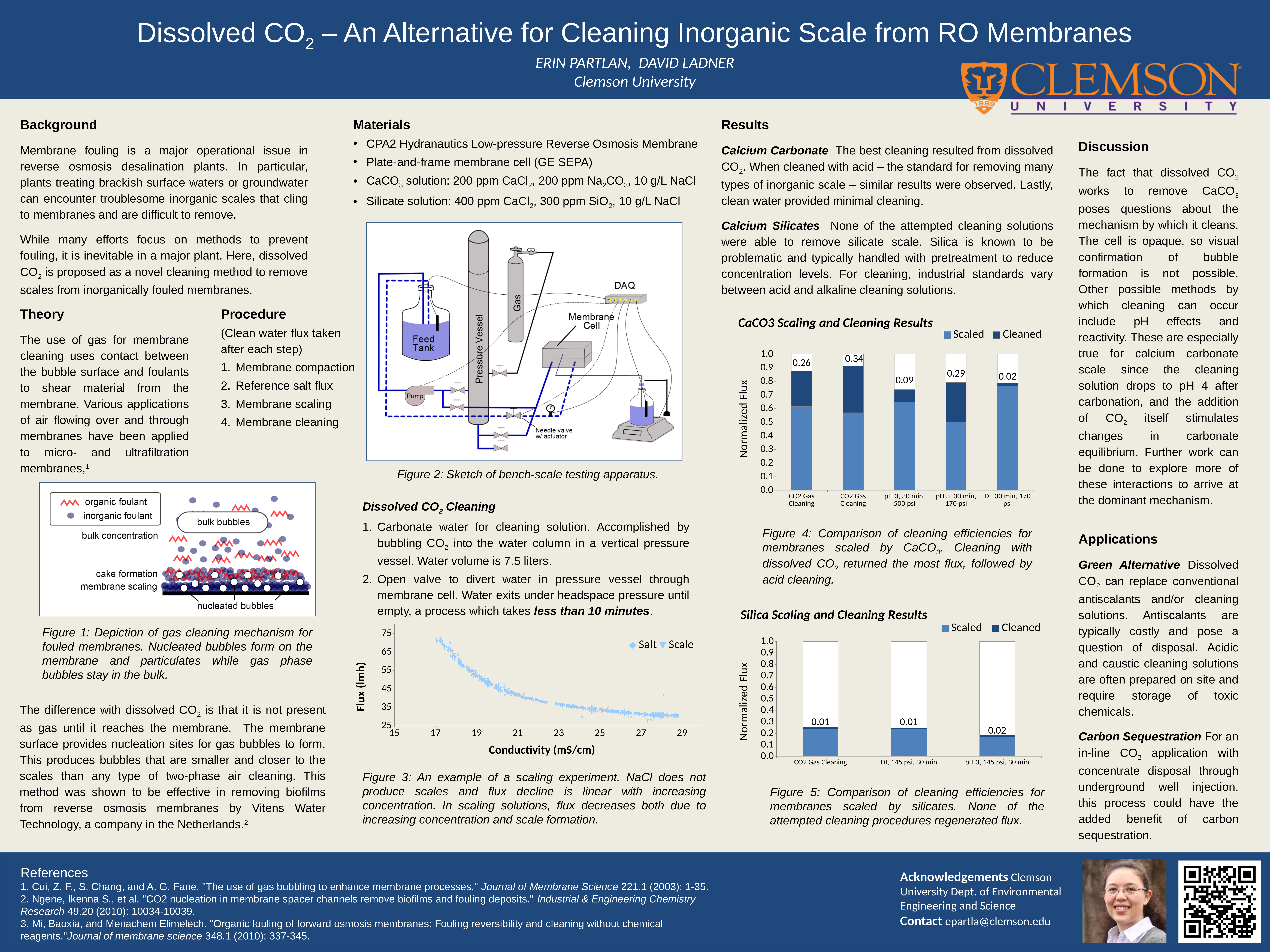
In the 'Silica Scaling and Cleaning Results' chart, how many categories are shown on the x axis? 3 In the 'CaCO3 Scaling and Cleaning Results' chart, what is the difference between the Cleaned values for 'pH 3, 30 min, 170 psi' and 'pH 3, 30 min, 500 psi'? 0.20 In the 'CaCO3 Scaling and Cleaning Results' chart, what kind of chart is shown? bar chart In the 'CaCO3 Scaling and Cleaning Results' chart, how many categories are shown on the x axis? 5 In the 'Silica Scaling and Cleaning Results' chart, is the Scaled value for 'CO2 Gas Cleaning' greater or less than 0.3? less In the 'CaCO3 Scaling and Cleaning Results' chart, what is the Cleaned value for 'DI, 30 min, 170 psi'? 0.02 In the 'CaCO3 Scaling and Cleaning Results' chart, how many series does the legend list? 2 In the 'Silica Scaling and Cleaning Results' chart, what is the Cleaned value for 'pH 3, 145 psi, 30 min'? 0.02 In the 'CaCO3 Scaling and Cleaning Results' chart, what is the Cleaned value for 'pH 3, 30 min, 500 psi'? 0.09 In the Figure 3 chart of Flux versus Conductivity, does flux rise or fall as conductivity increases? fall In the 'CaCO3 Scaling and Cleaning Results' chart, which category has the lowest Cleaned value? DI, 30 min, 170 psi In the 'CaCO3 Scaling and Cleaning Results' chart, is the Scaled value for 'pH 3, 30 min, 500 psi' greater or less than 0.5? greater